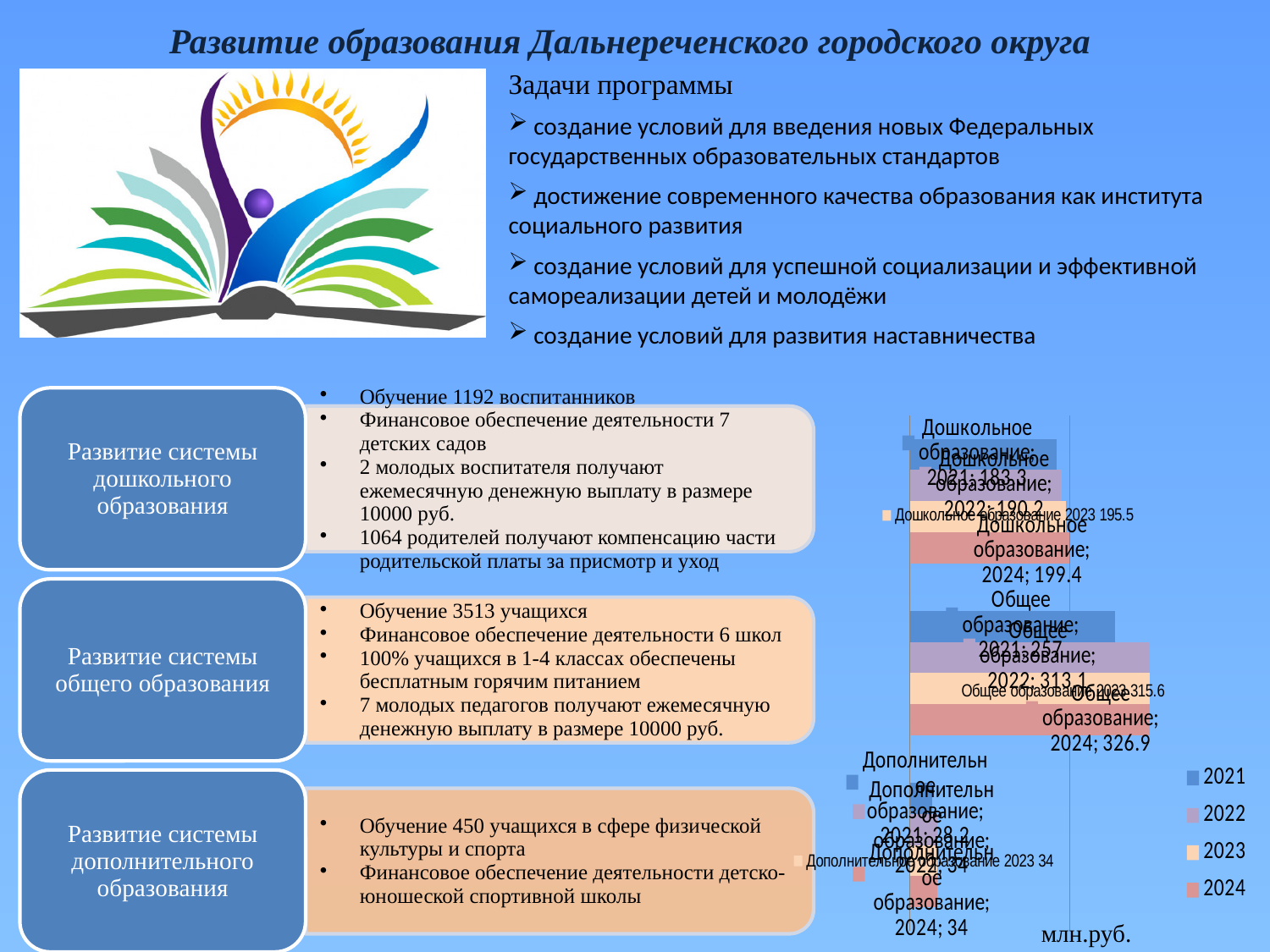
Which category has the highest value in 2024? Общее образование What is the difference between the 2024 and 2021 values for Общее образование? 69.9 What kind of chart is shown on the right side of the slide? bar chart Which years are listed in the chart legend? 2021, 2022, 2023, 2024 What is the value for Дошкольное образование in 2024? 199.4 Do the values for Дошкольное образование rise or fall from 2021 to 2024? rise What is the value for Дошкольное образование in 2022? 190.2 What is the value for Общее образование in 2024? 326.9 Which category has the lowest value in 2021? Дополнительное образование What is the value for Общее образование in 2021? 257 What is the value for Дополнительное образование in 2021? 28.2 How many series does the legend of the chart list? 4